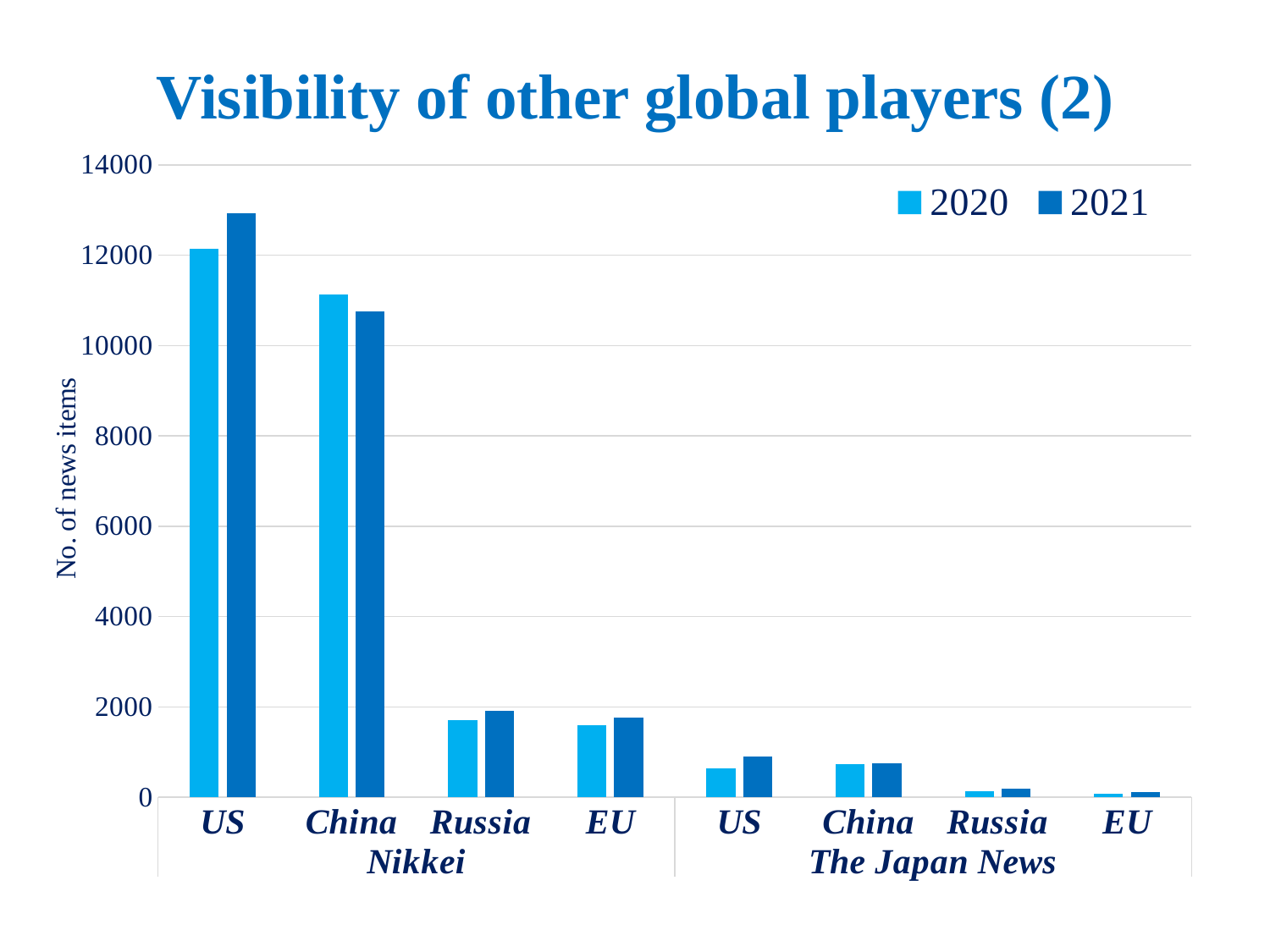
Is the 2020 value for Russia under Nikkei greater or less than 2000? less What is the label of the vertical axis? No. of news items How many categories are plotted along the x axis in total? 8 Under Nikkei, which year has the larger value for China: 2020 or 2021? 2020 What are the two series named in the legend? 2020 and 2021 Which bar is the tallest in the chart? US 2021 (Nikkei) How many series does the legend list? 2 Is the 2021 value for US under Nikkei greater or less than 12000? greater Is the 2021 value for China under Nikkei greater or less than 10000? greater Under Nikkei, which is larger for 2020: US or China? US Which category has the lowest values under The Japan News? EU What kind of chart is shown on the slide? bar chart